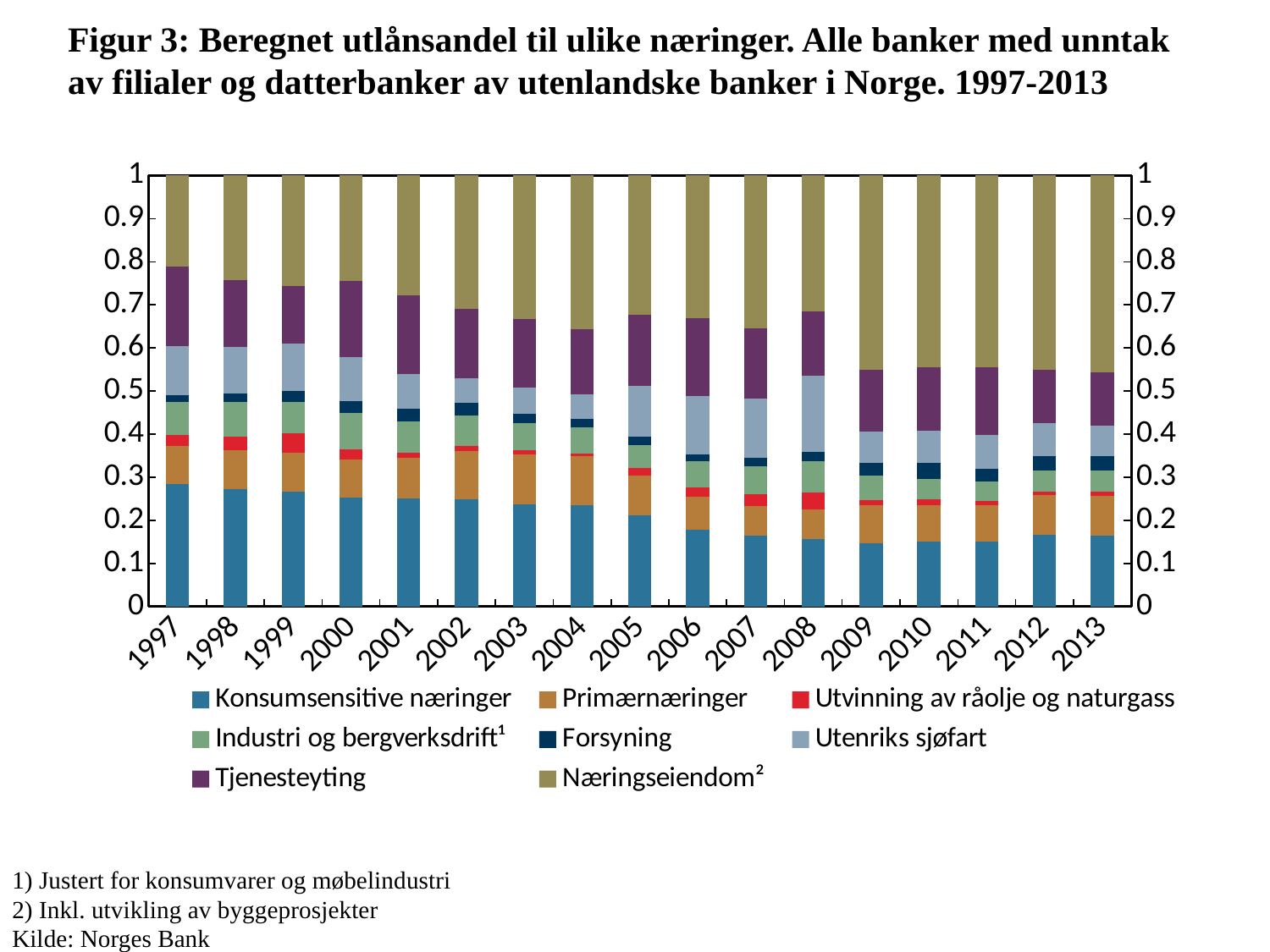
Which is larger, the Konsumsensitive næringer share in 1997 or in 2013? 1997 How many series does the legend list? 8 How many years (categories) are shown on the x axis? 17 Is the share for Konsumsensitive næringer in 2009 greater or less than 0.2? less Which series is shown at the top of each stacked bar? Næringseiendom Does the share for Konsumsensitive næringer rise or fall from 1997 to 2013? fall Does the share for Næringseiendom rise or fall from 1997 to 2013? rise Is the share for Konsumsensitive næringer in 1997 greater or less than 0.2? greater Is the share for Næringseiendom in 2013 greater or less than 0.4? greater What kind of chart is shown on the slide? Stacked bar chart What is the total of the stacked bar for 2005? 1